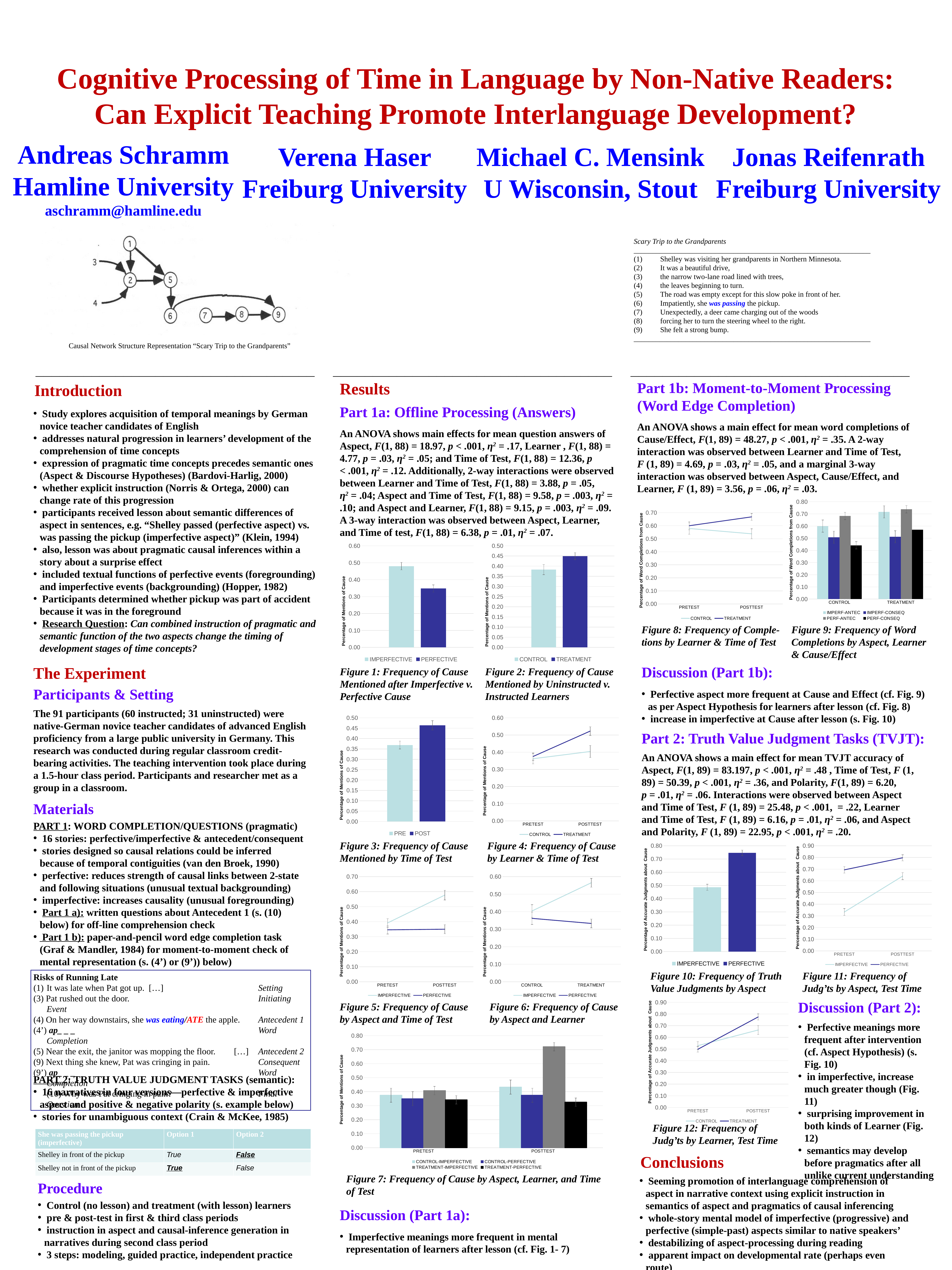
In Figure 1 (Frequency of Cause Mentioned after Imperfective v. Perfective Cause), which category has the higher bar? Imperfective In Figure 6 (Frequency of Cause by Aspect and Learner), does the Perfective line rise or fall from Control to Treatment? fall In Figure 2 (Frequency of Cause Mentioned by Uninstructed v. Instructed Learners), which is larger, Control or Treatment? Treatment In Figure 9 (Frequency of Word Completions by Aspect, Learner & Cause/Effect), which series has the tallest bar in the Treatment group? PERF-ANTEC In Figure 3 (Frequency of Cause Mentioned by Time of Test), is the value for Post greater or less than 0.40? greater In Figure 10 (Frequency of Truth Value Judgments by Aspect), is the value for Perfective greater or less than 0.70? greater In Figure 1 (Frequency of Cause Mentioned after Imperfective v. Perfective Cause), is the value for Perfective greater or less than 0.40? less What kind of chart is Figure 12 (Frequency of Judg'ts by Learner, Test Time)? line chart In Figure 8 (Frequency of Completions by Learner & Time of Test), does the Control line rise or fall from Pretest to Posttest? fall In Figure 7 (Frequency of Cause by Aspect, Learner, and Time of Test), which series has the tallest bar at Posttest? Treatment-Imperfective How many series does the legend of Figure 7 (Frequency of Cause by Aspect, Learner, and Time of Test) list? 4 In Figure 5 (Frequency of Cause by Aspect and Time of Test), does the Imperfective line rise or fall from Pretest to Posttest? rise